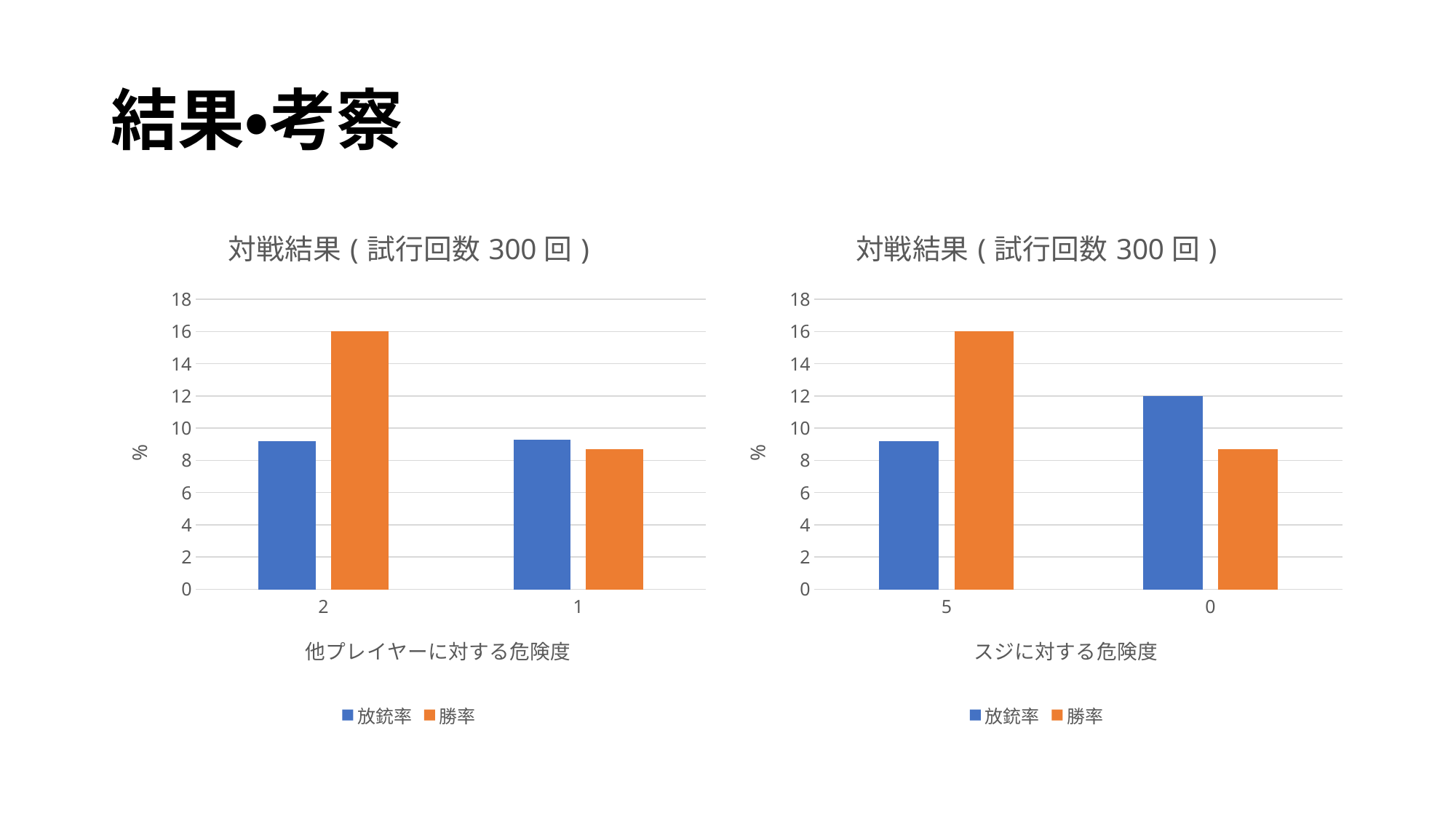
In the left chart, for category 2, which is larger, 放銃率 or 勝率? 勝率 In the left chart (x axis 他プレイヤーに対する危険度), what is the 勝率 value for category 2? 16 In the right chart (x axis スジに対する危険度), what is the 勝率 value for category 5? 16 What is the x-axis title of the right chart? スジに対する危険度 What kind of chart is the left chart? bar chart In the left chart, is the 放銃率 value for category 1 greater or less than 10? less In the right chart, for category 0, which is larger, 放銃率 or 勝率? 放銃率 How many categories are shown on the x axis of the right chart? 2 How many series does the legend of the left chart list? 2 In the left chart, does the 勝率 series rise or fall from category 2 to category 1? fall In the right chart, is the 勝率 value for category 0 greater or less than 10? less In the right chart (x axis スジに対する危険度), what is the 放銃率 value for category 0? 12